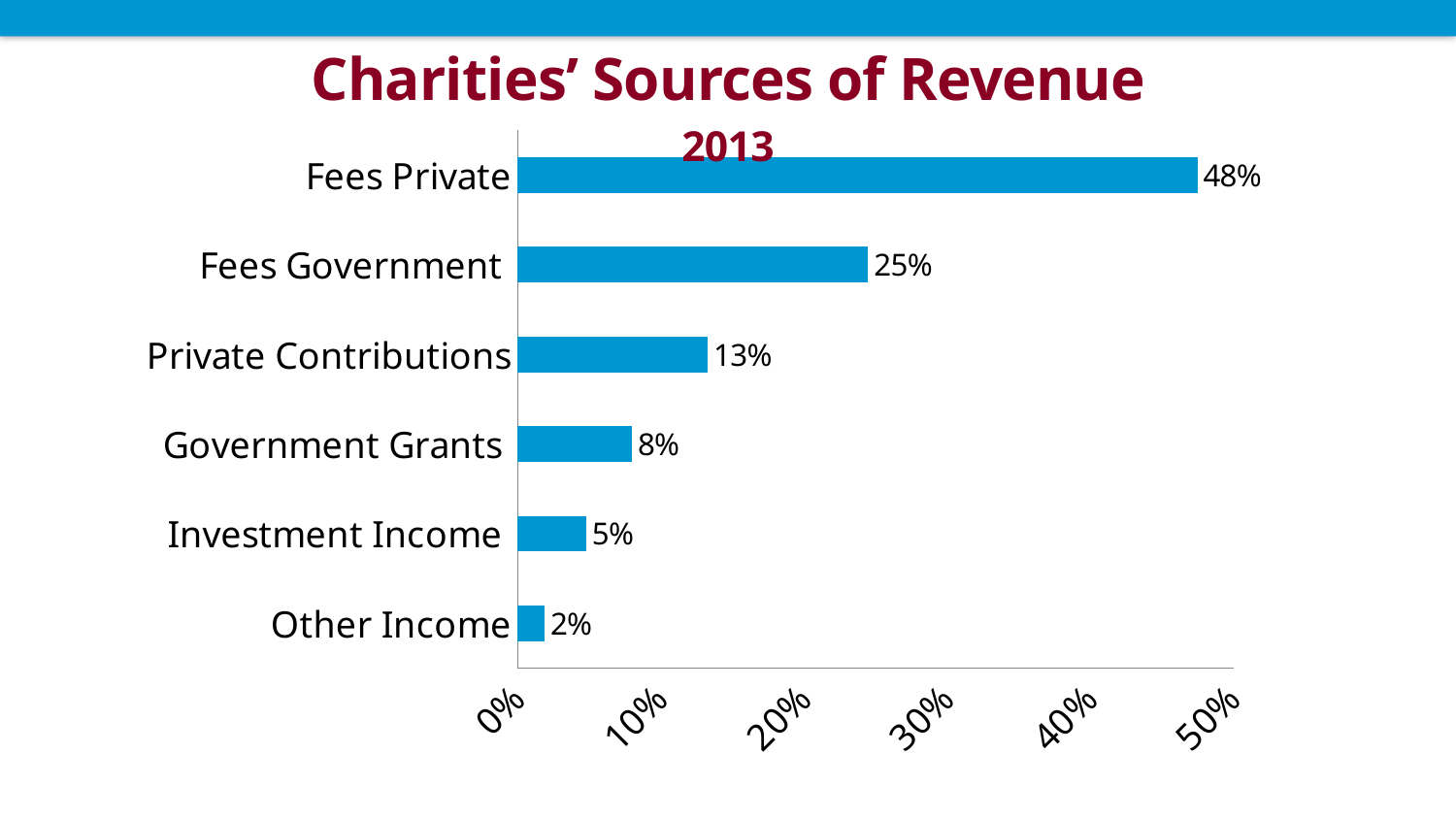
Which is larger, Private Contributions or Government Grants? Private Contributions What is the value for Private Contributions? 13% Which source of revenue has the highest value? Fees Private How many categories are shown in the chart? 6 What is the difference between Fees Private and Fees Government? 23% What is the value for Fees Private? 48% What is the value for Investment Income? 5% What is the title of the chart? Charities' Sources of Revenue 2013 What is the difference between Government Grants and Other Income? 6% What kind of chart is shown on the slide? Bar chart What is the value for Fees Government? 25% Which source of revenue has the lowest value? Other Income